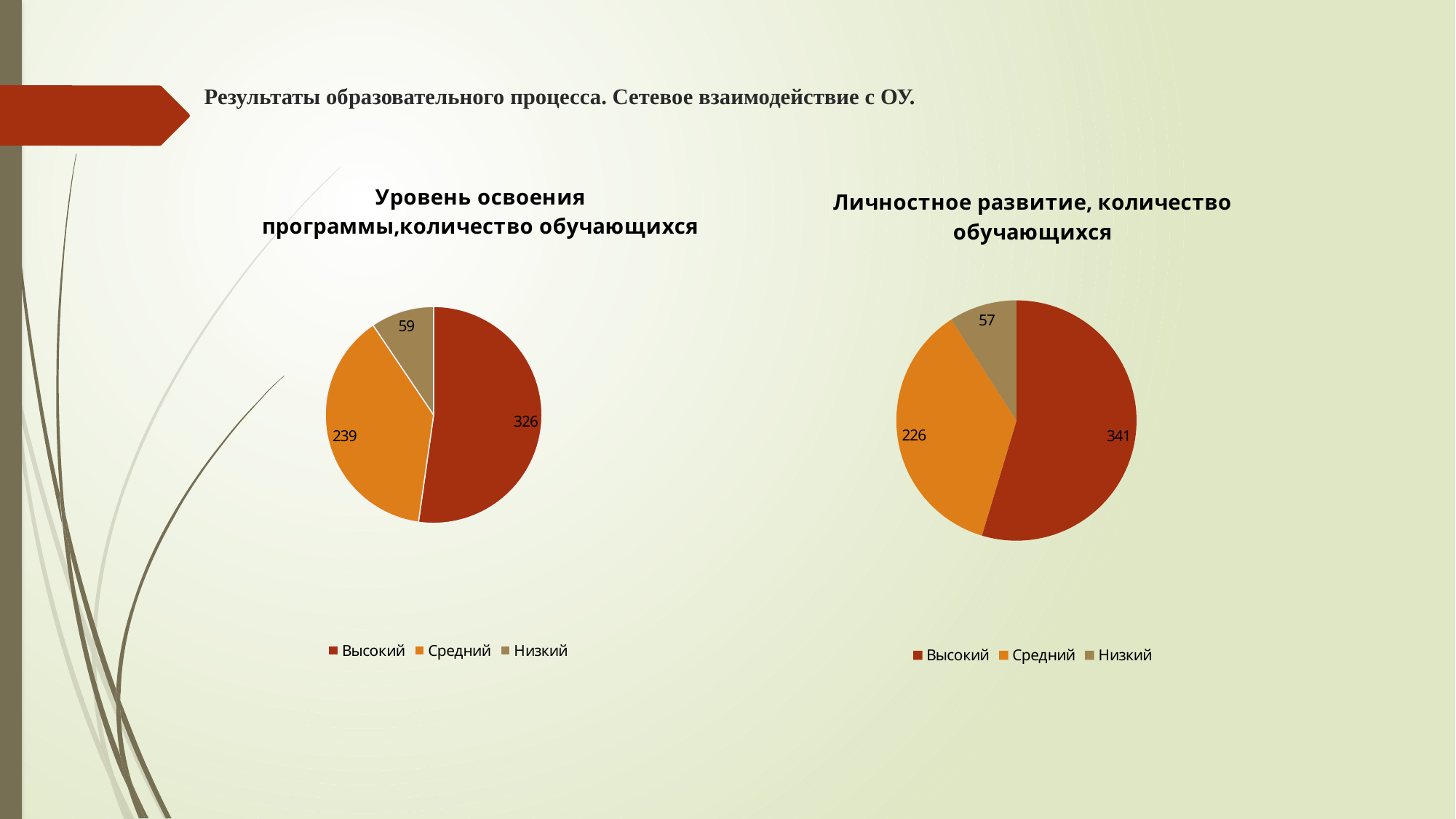
What type of chart is used on the left of the slide, titled 'Уровень освоения программы,количество обучающихся'? Pie chart In the left chart 'Уровень освоения программы,количество обучающихся', what is the value for Низкий? 59 What is the total of all slices in the left chart 'Уровень освоения программы,количество обучающихся'? 624 In the left chart 'Уровень освоения программы,количество обучающихся', what is the difference between Высокий and Средний? 87 In the right chart 'Личностное развитие, количество обучающихся', which category has the largest slice? Высокий How many categories does the right chart 'Личностное развитие, количество обучающихся' show? 3 Which is larger: Средний in the left chart 'Уровень освоения программы,количество обучающихся' or Средний in the right chart 'Личностное развитие, количество обучающихся'? Средний in the left chart (239) In the left chart 'Уровень освоения программы,количество обучающихся', which category has the smallest slice? Низкий In the left chart 'Уровень освоения программы,количество обучающихся', what is the value for Высокий? 326 What are the legend entries of the left chart 'Уровень освоения программы,количество обучающихся'? Высокий, Средний, Низкий In the right chart 'Личностное развитие, количество обучающихся', what is the value for Средний? 226 In the right chart 'Личностное развитие, количество обучающихся', what is the difference between Высокий and Низкий? 284